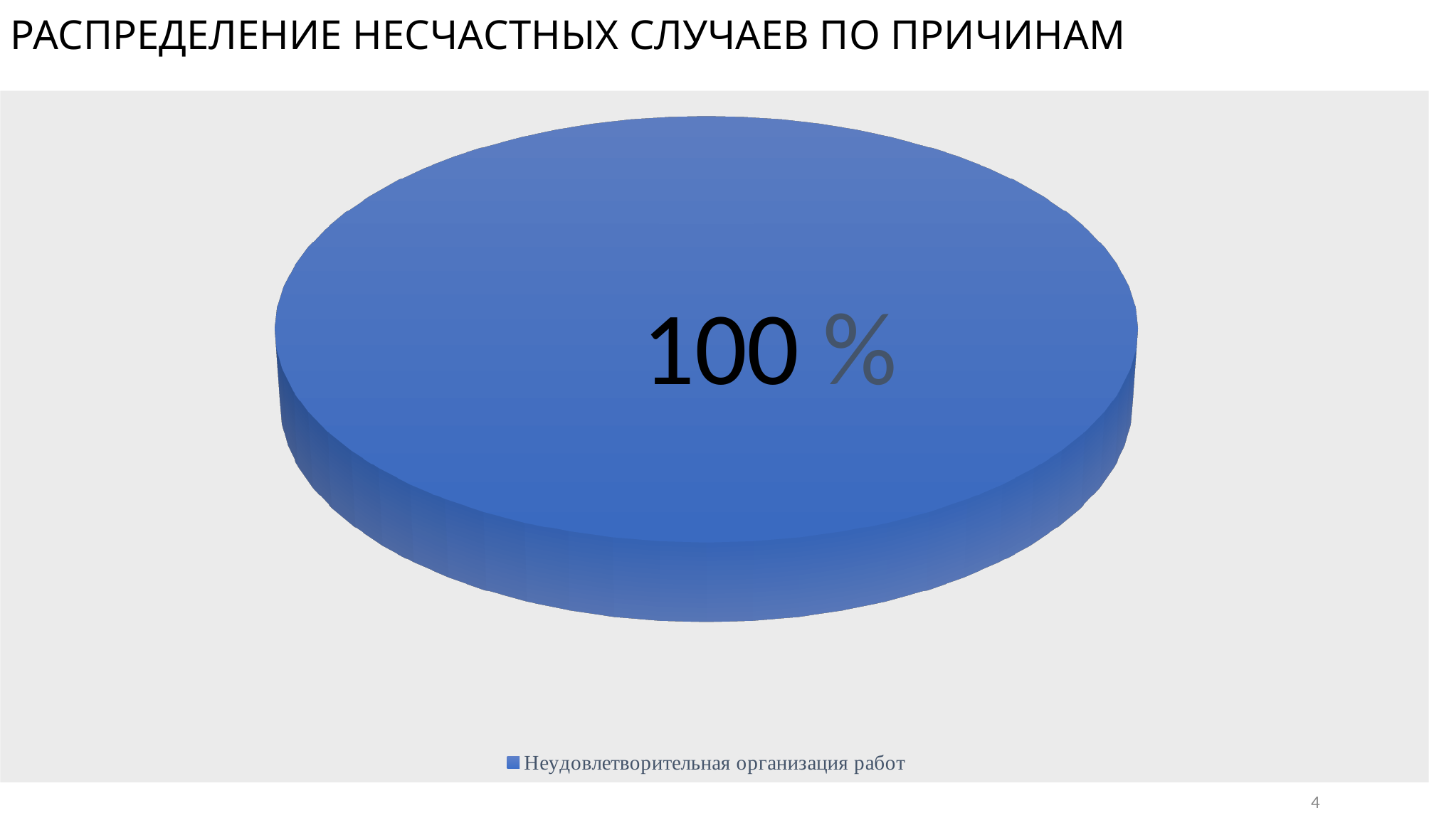
What is the title of the slide containing the pie chart? РАСПРЕДЕЛЕНИЕ НЕСЧАСТНЫХ СЛУЧАЕВ ПО ПРИЧИНАМ What is the legend entry for the pie chart? Неудовлетворительная организация работ How many slices does the pie chart have? 1 What kind of chart is shown on the slide? pie chart How many entries does the legend list? 1 Is the value for 'Неудовлетворительная организация работ' greater or less than 50 %? greater What share of the pie does the slice 'Неудовлетворительная организация работ' represent? 100 % What value is printed on the pie slice? 100 %